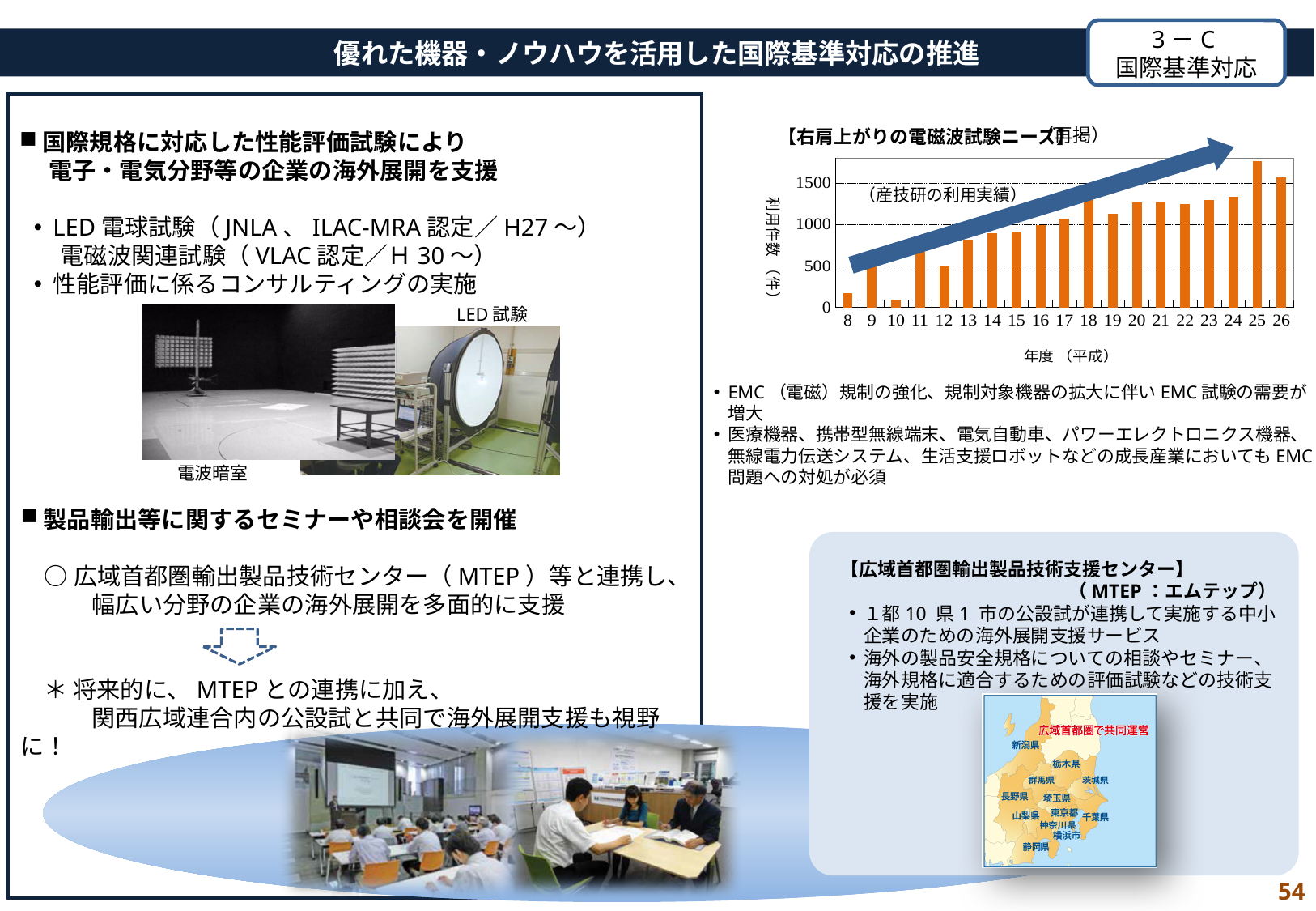
Which year (平成) has the highest 利用件数 in the chart? 25 Which year (平成) has the lowest 利用件数 in the chart? 10 How many years (categories) are plotted on the x axis of the chart? 19 What kind of chart is shown on the slide? Bar chart Which year has the larger 利用件数, year 9 or year 11? 11 Is the value for year 18 greater or less than 1000? greater Is the value for year 8 greater or less than 500? less Is the value for year 13 greater or less than 1000? less Overall, do the values in the chart rise or fall from year 8 to year 26? Rise Which year has the larger 利用件数, year 26 or year 24? 26 What is the label of the x axis of the chart? 年度（平成）